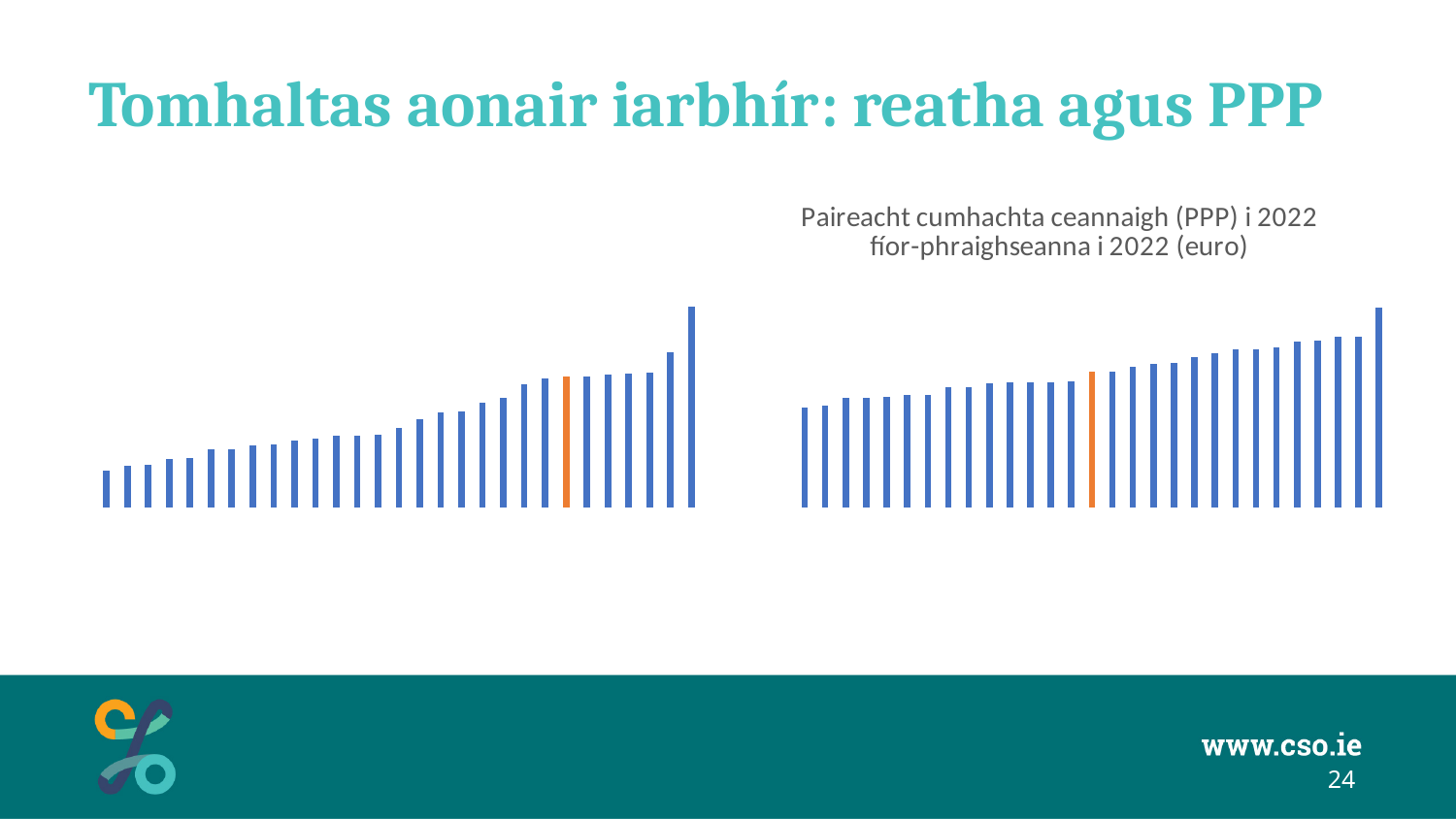
In the chart on the left of the slide, is the tallest bar at the left end or the right end of the chart? Right end How many charts are shown on the slide? 2 In the chart on the left of the slide, which is larger: the rightmost bar or the leftmost bar? The rightmost bar What is the title of the chart on the right of the slide? Paireacht cumhachta ceannaigh (PPP) i 2022 fíor-phraighseanna i 2022 (euro) What colour is the single highlighted bar in each chart on the slide? Orange In the chart on the right of the slide, is the shortest bar at the left end or the right end of the chart? Left end In the chart on the right of the slide, do the bar values rise or fall from left to right? Rise In the chart on the left of the slide, do the bar values rise or fall from left to right? Rise What kind of chart is the chart titled 'Paireacht cumhachta ceannaigh (PPP) i 2022 fíor-phraighseanna i 2022 (euro)'? Bar chart What kind of chart is the chart on the left of the slide? Bar chart In the chart on the right of the slide, which is larger: the orange bar or the rightmost bar? The rightmost bar